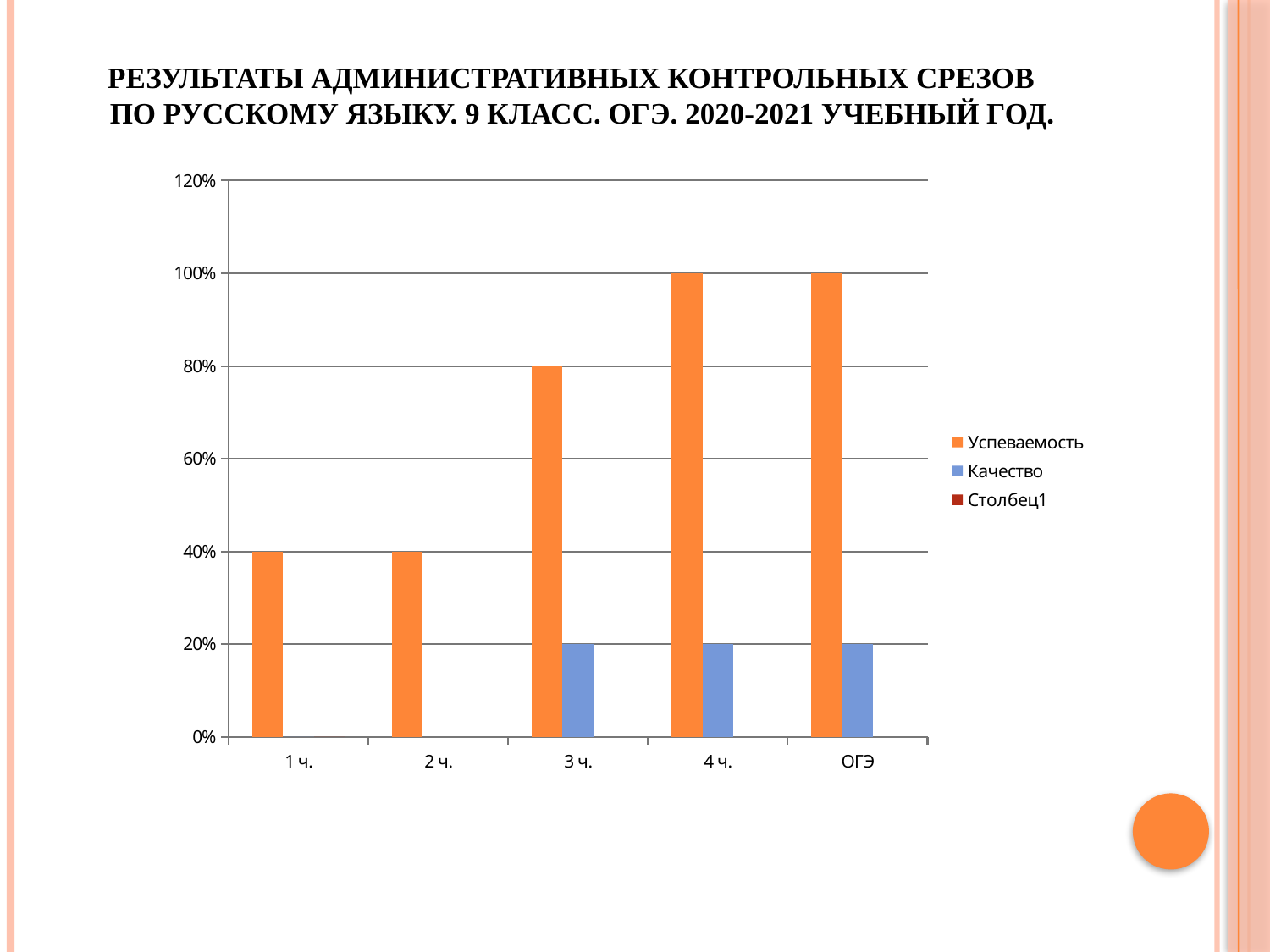
What is the value of Успеваемость for 1 ч.? 40% Which category has the lowest Успеваемость value? 1 ч. and 2 ч. What is the value of Успеваемость for 3 ч.? 80% What is the value of Успеваемость for ОГЭ? 100% What is the difference between Успеваемость for 4 ч. and Успеваемость for 2 ч.? 60% How many series does the legend list? 3 Which is larger: Успеваемость for 3 ч. or Успеваемость for 2 ч.? Успеваемость for 3 ч. How many categories are shown on the x axis? 5 Does the Успеваемость series rise or fall from 1 ч. to 4 ч.? rise What kind of chart is shown on the slide? bar chart Which colour represents the Качество series in the legend? blue What is the value of Качество for 4 ч.? 20%